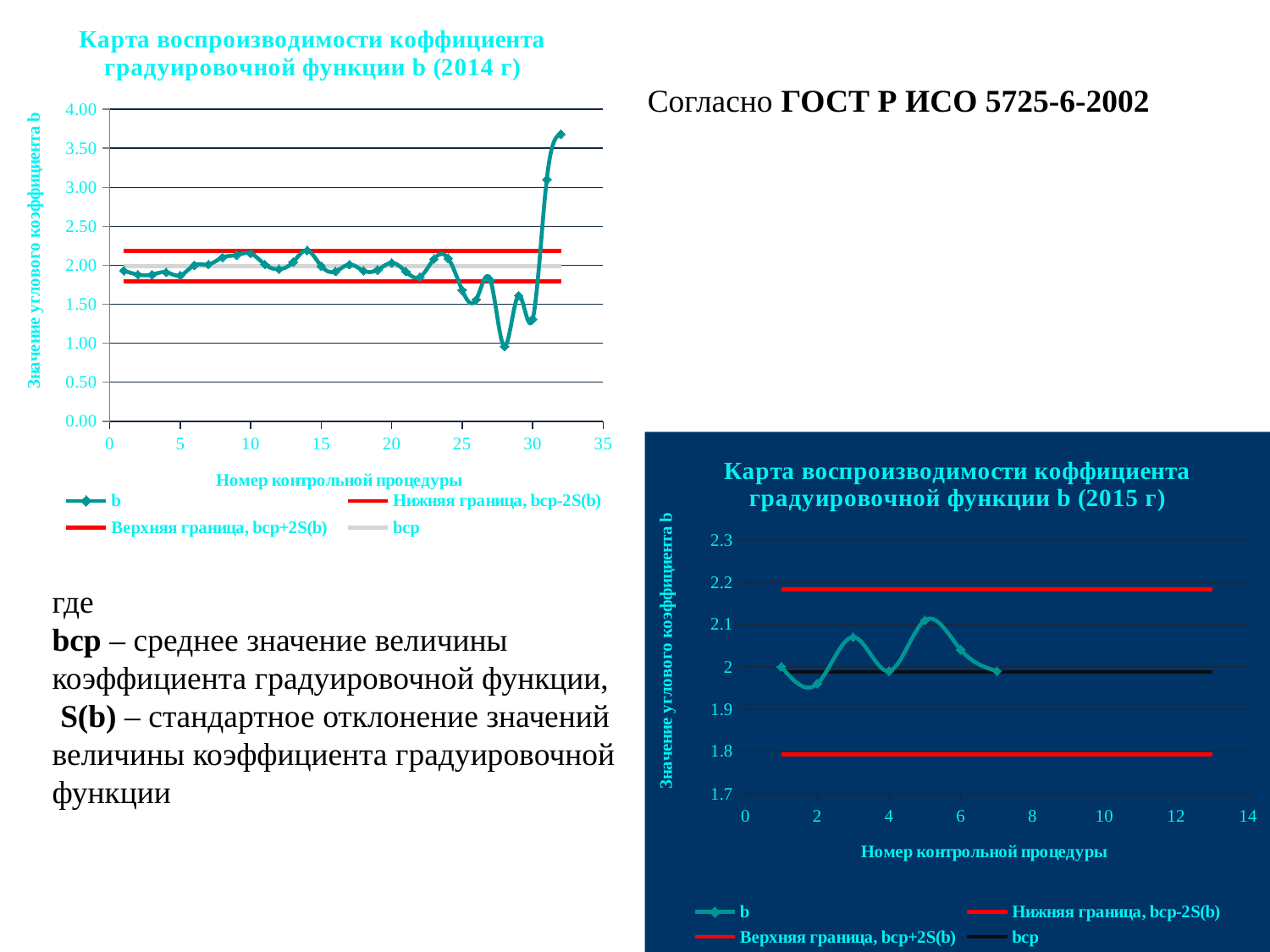
What kind of chart is the 2014 chart (Карта воспроизводимости коэффициента градуировочной функции b (2014 г))? line chart In the 2015 chart, at which control procedure number does series b reach its highest value? 5 In the 2014 chart, which legend entry is drawn in grey? bcp In the 2014 chart, is the upper limit line (Верхняя граница, bcp+2S(b)) greater or less than 2.00? greater What is the label of the x axis of the 2015 chart? Номер контрольной процедуры How many series does the legend of the 2015 chart list? 4 In the 2015 chart, is the value of b at control procedure 3 greater or less than 2? greater In the 2015 chart, how many data points does series b have? 7 In the 2014 chart, is the value of b at control procedure 25 greater or less than 2.00? less In the 2014 chart, at which control procedure number does series b reach its highest value? 32 In the 2014 chart, at which control procedure number does series b reach its lowest value? 28